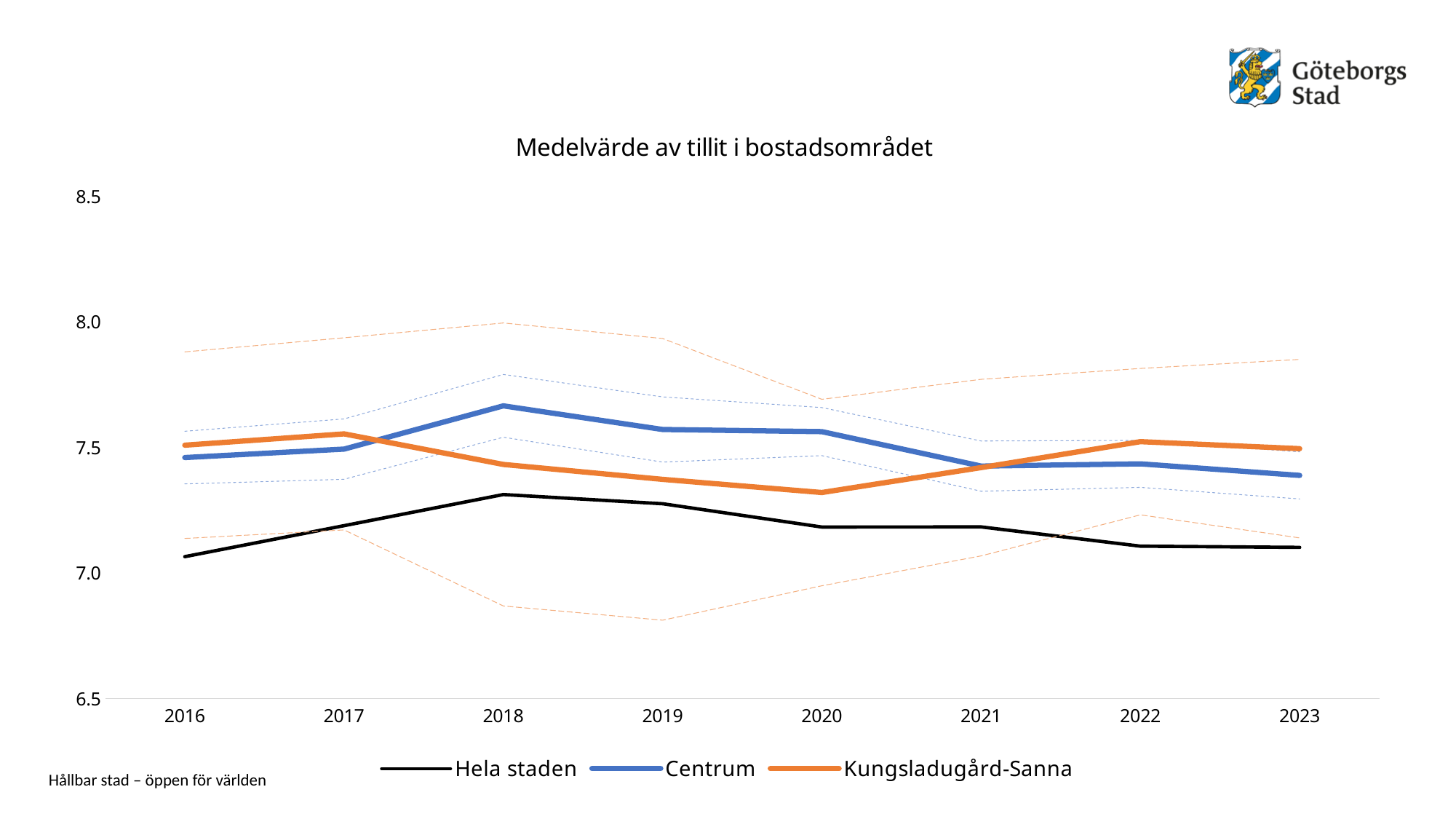
Does the Hela staden line rise or fall from 2018 to 2022? fall Which colour is used for the Kungsladugård-Sanna line? orange What is the title of the chart? Medelvärde av tillit i bostadsområdet What kind of chart is shown on the slide? line chart Is the value for Centrum in 2018 greater or less than 7.5? greater In which year does the Centrum line reach its highest value? 2018 Is the value for Kungsladugård-Sanna in 2020 greater or less than 7.5? less Is the value for Hela staden in 2016 greater or less than 7.5? less In 2018, which is higher: Centrum or Kungsladugård-Sanna? Centrum How many series does the legend list? 3 In which year does the Hela staden line reach its highest value? 2018 How many years are shown along the x axis? 8